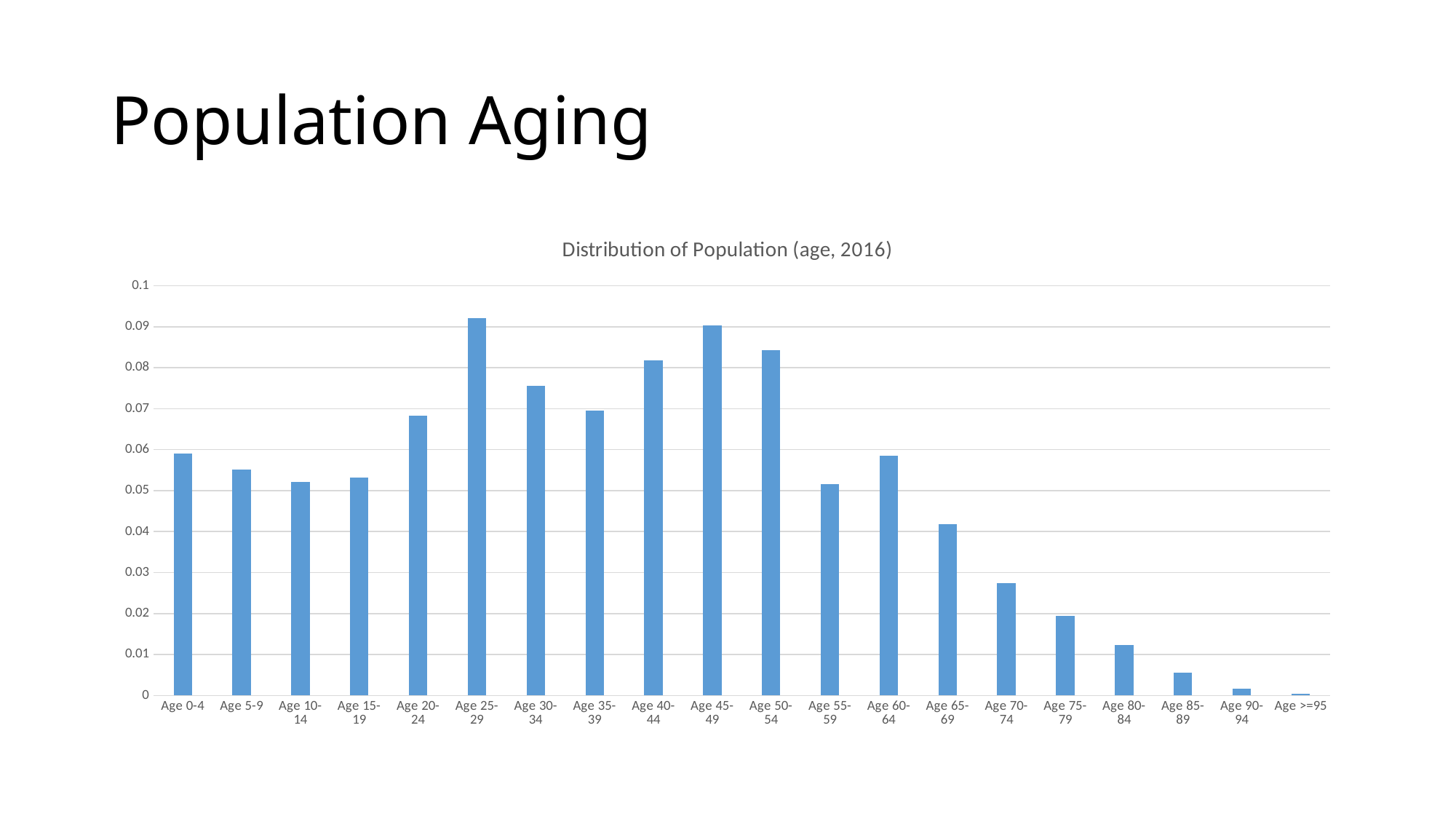
Is the value for Age 55-59 greater or less than 0.06? less Is the value for Age 0-4 greater or less than 0.05? greater How many age categories are plotted on the chart? 20 What is the title of the chart? Distribution of Population (age, 2016) Which age category has the lowest value? Age >=95 Is the value for Age 30-34 greater or less than 0.07? greater Which has the larger value, Age 75-79 or Age 85-89? Age 75-79 Which has the larger value, Age 20-24 or Age 60-64? Age 20-24 Which age category has the highest value? Age 25-29 What kind of chart is shown on the slide? bar chart